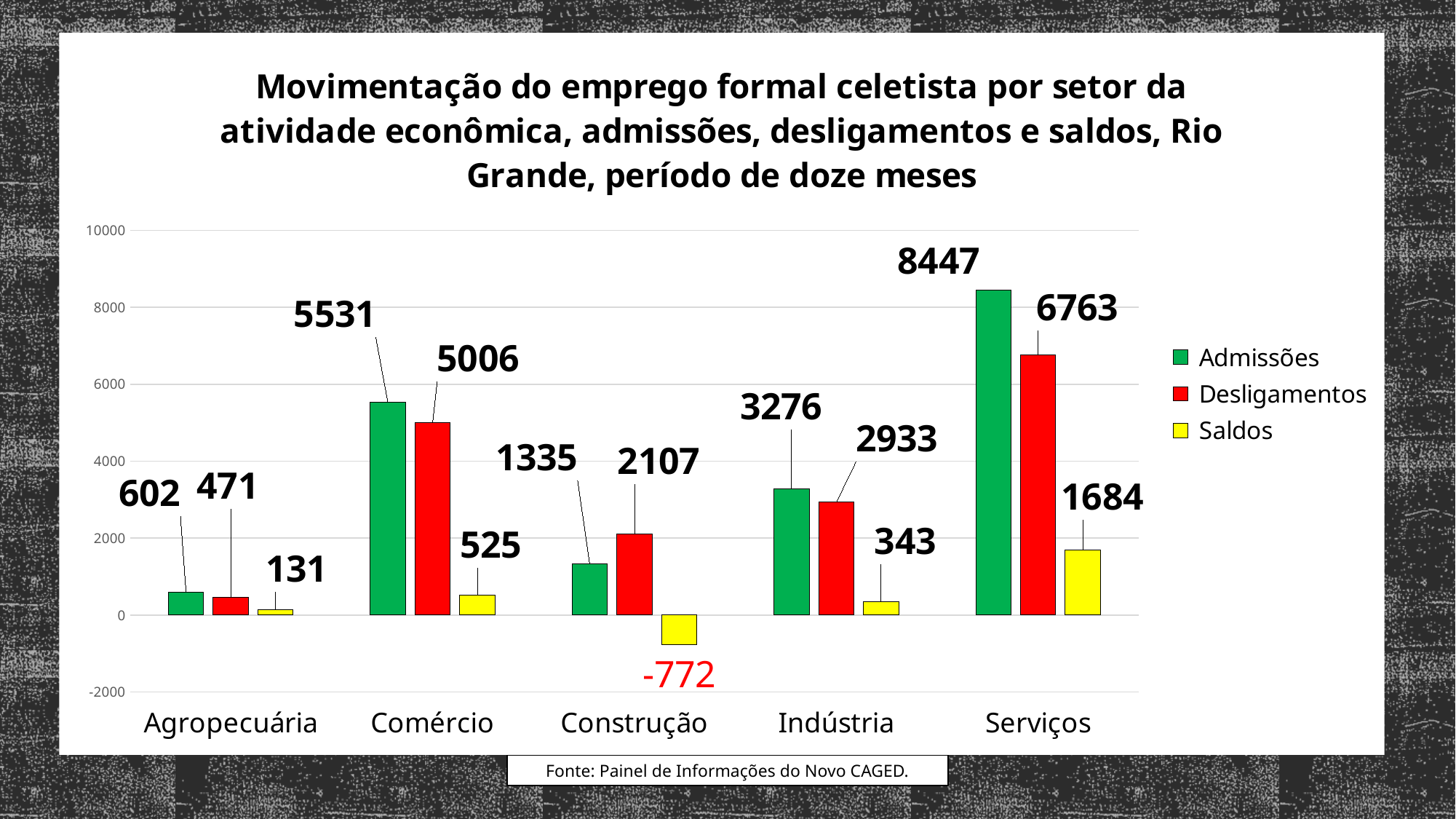
What is the Saldos value for Construção? -772 What is the Desligamentos value for Construção? 2107 What is the difference between Admissões and Desligamentos for Comércio? 525 Is the Desligamentos value for Serviços greater or less than 6000? greater Which sector has the highest Admissões value? Serviços Which sector has the lowest Saldos value? Construção What colour represents the Saldos series? Yellow Which is larger for Indústria, Admissões or Desligamentos? Admissões What kind of chart is shown on the slide? Bar chart How many series does the legend list? 3 How many sectors are shown on the x axis? 5 What is the Admissões value for Serviços? 8447